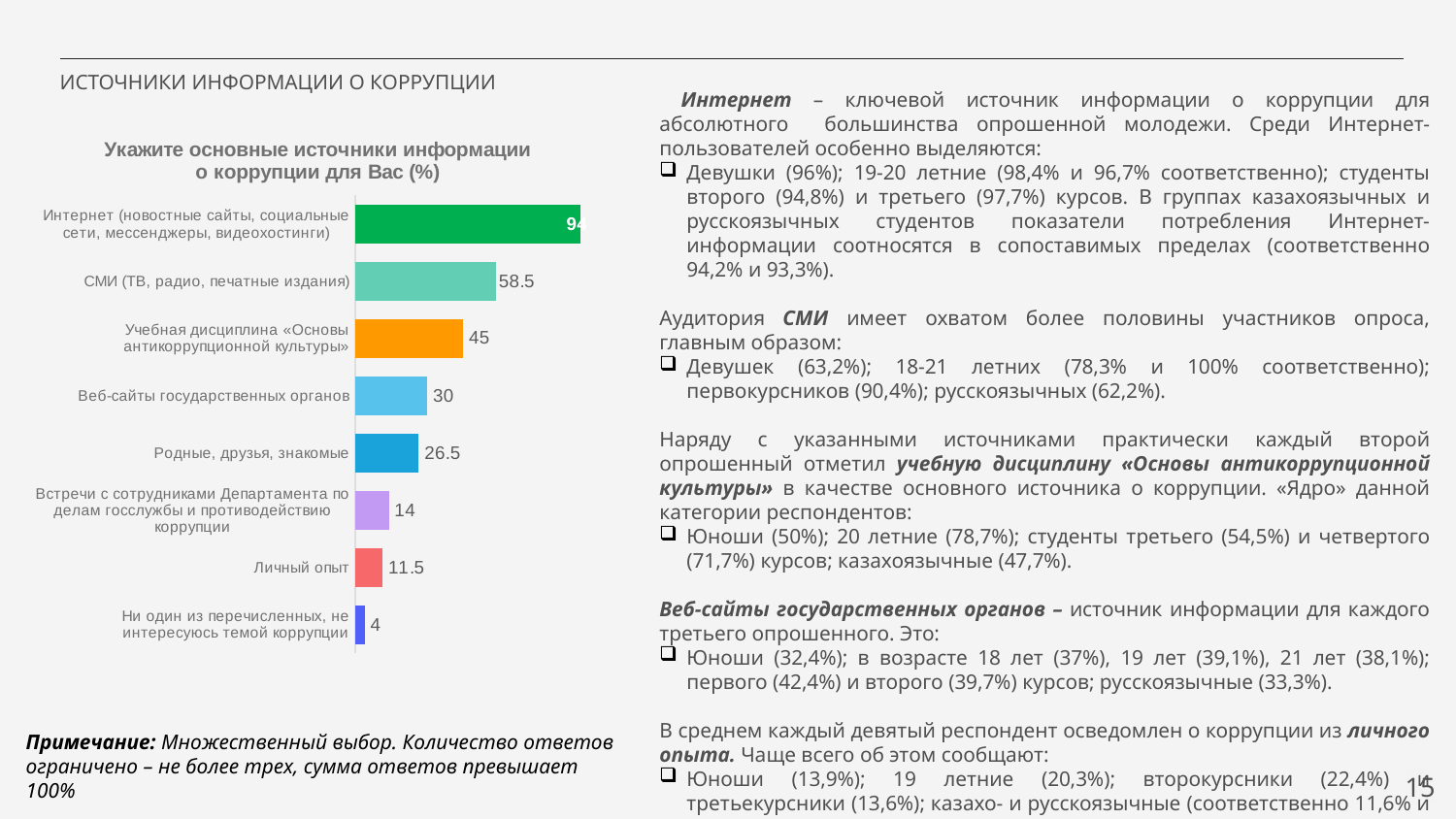
What value is shown for «СМИ (ТВ, радио, печатные издания)»? 58.5 Which is larger: the value for «Родные, друзья, знакомые» or the value for «Встречи с сотрудниками Департамента по делам госслужбы и противодействию коррупции»? Родные, друзья, знакомые What is the difference between the values for «Интернет» and «СМИ (ТВ, радио, печатные издания)»? 35.5 How many categories are shown in the chart? 8 Which category has the highest value in the chart? Интернет (новостные сайты, социальные сети, мессенджеры, видеохостинги) Which category has the lowest value in the chart? Ни один из перечисленных, не интересуюсь темой коррупции What is the title of the chart? Укажите основные источники информации о коррупции для Вас (%) What value is shown for «Веб-сайты государственных органов»? 30 What value is shown for «Личный опыт»? 11.5 What value is shown for «Интернет (новостные сайты, социальные сети, мессенджеры, видеохостинги)»? 94 What type of chart is shown on the slide? Bar chart What is the difference between the values for «Учебная дисциплина «Основы антикоррупционной культуры»» and «Веб-сайты государственных органов»? 15